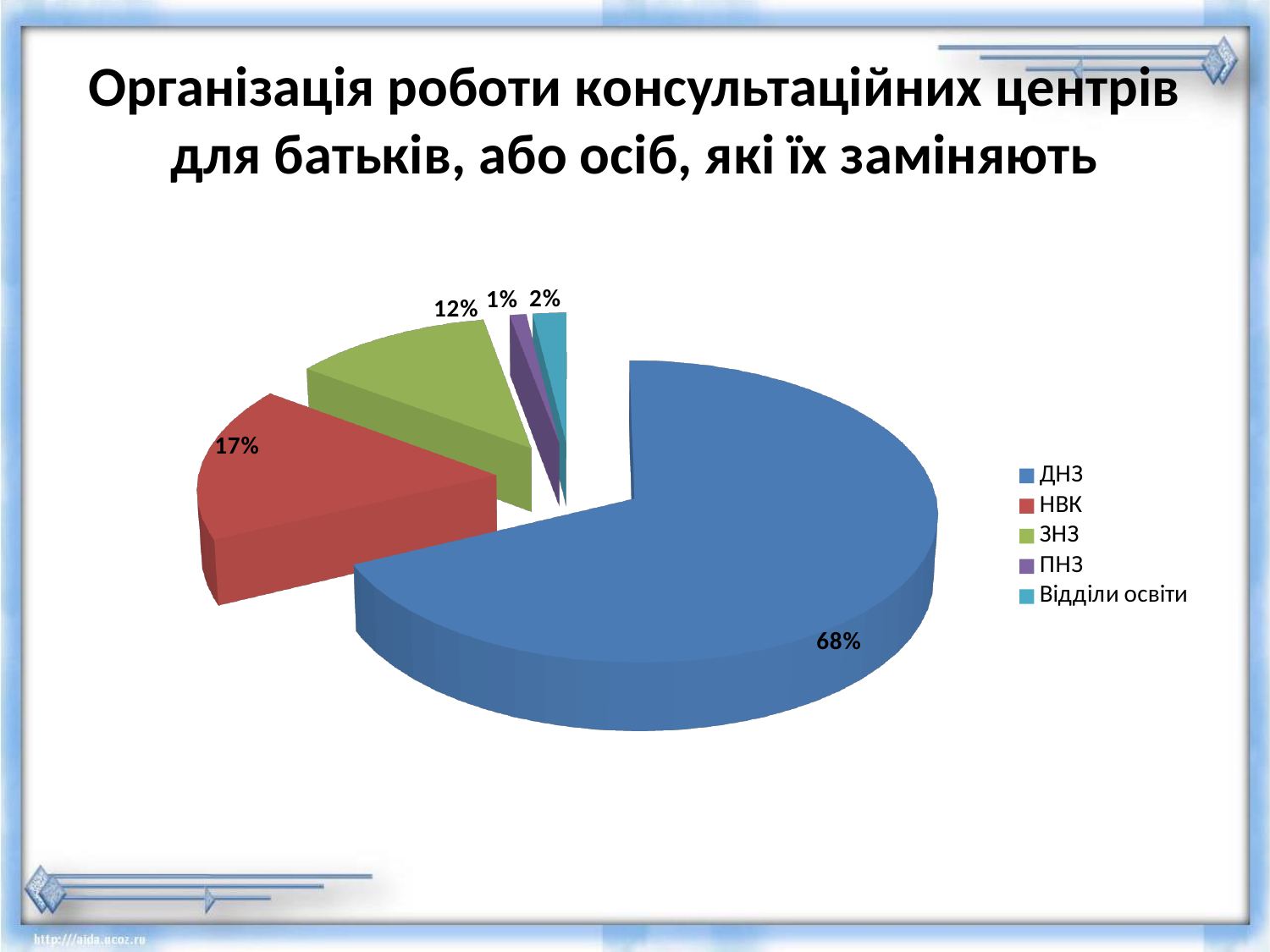
How many categories does the legend list? 5 What kind of chart is shown on the slide? pie chart What share of the pie does ЗНЗ have? 12% What share of the pie does НВК have? 17% Which slice is larger, НВК or ЗНЗ? НВК What is the difference in percentage points between the ДНЗ and НВК slices? 51 Which category has the smallest slice of the pie? ПНЗ What share of the pie does ПНЗ have? 1% What colour is the slice for ЗНЗ? green Which category has the largest slice of the pie? ДНЗ